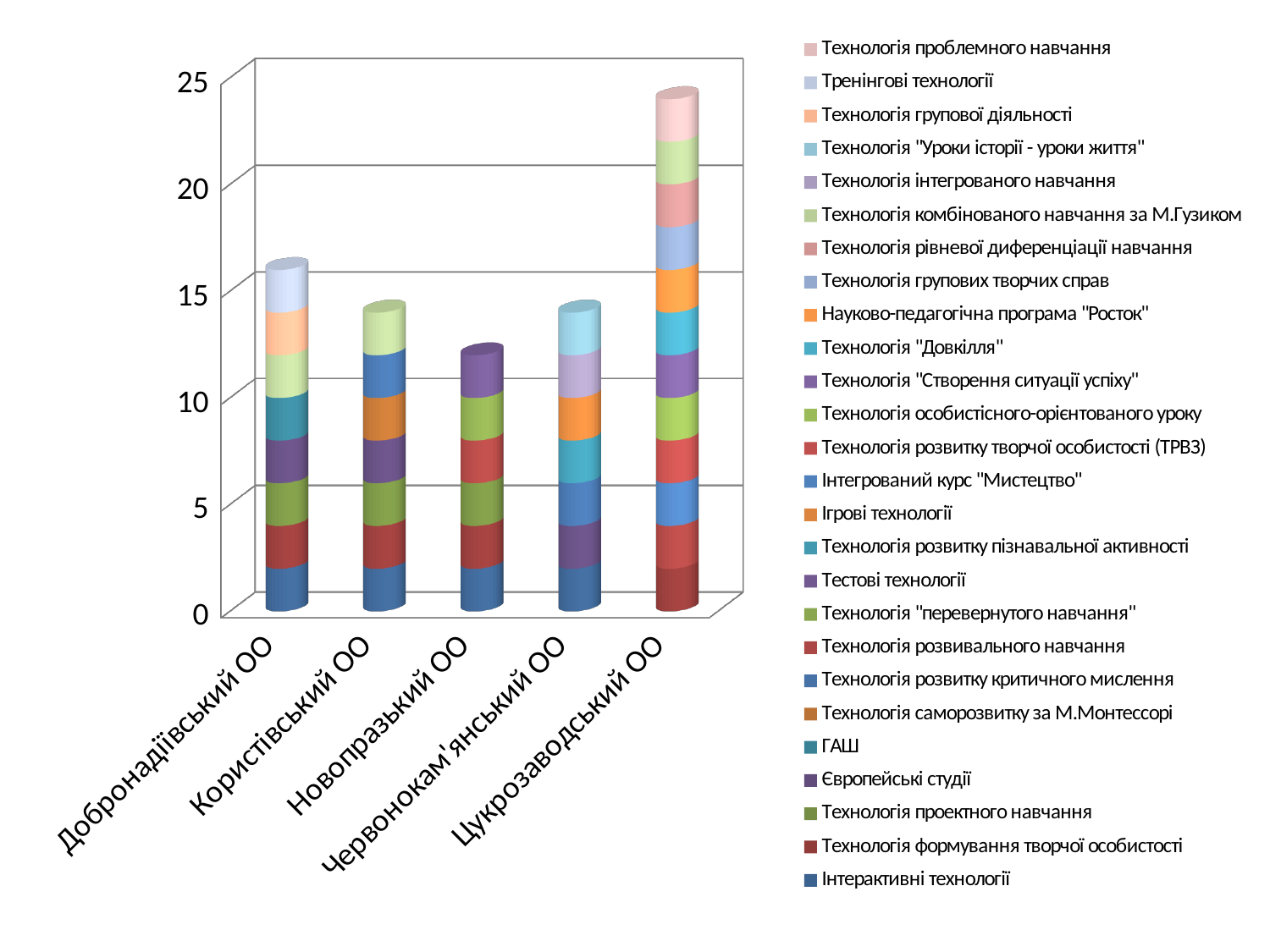
How many series does the legend list? 26 Which category has the tallest stacked bar? Цукрозаводський ОО What kind of chart is shown on the slide? bar chart Is the total for Цукрозаводський ОО greater or less than 20? greater Which category has the shortest stacked bar? Новопразький ОО Which has the larger total, Цукрозаводський ОО or Новопразький ОО? Цукрозаводський ОО How many categories are shown along the x axis? 5 Which series is listed first (at the top) in the legend? Технологія проблемного навчання Is the total for Новопразький ОО greater or less than 10? greater Is the total for Новопразький ОО greater or less than 15? less Which series is listed last (at the bottom) in the legend? Інтерактивні технології